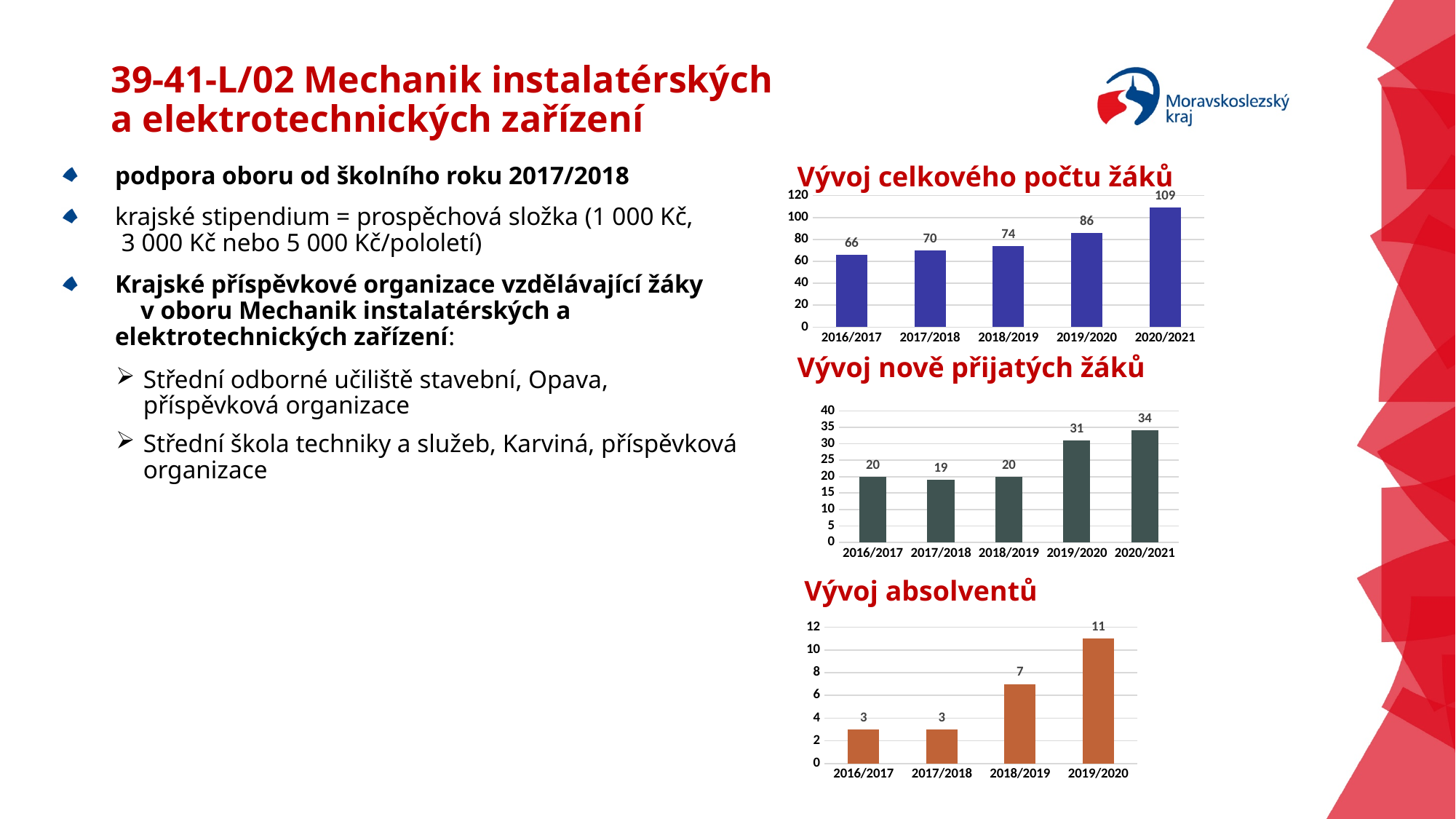
In the 'Vývoj celkového počtu žáků' chart, do the values rise or fall from 2016/2017 to 2020/2021? rise In the 'Vývoj celkového počtu žáků' chart, which school year has the lowest value? 2016/2017 In the 'Vývoj nově přijatých žáků' chart, which school year has the highest value? 2020/2021 In the 'Vývoj absolventů' chart, what is the difference between the values for 2019/2020 and 2016/2017? 8 What type of chart is the 'Vývoj absolventů' chart? bar chart In the 'Vývoj absolventů' chart, what is the value for 2018/2019? 7 In the 'Vývoj nově přijatých žáků' chart, what is the value for 2019/2020? 31 How many school years are shown in the 'Vývoj absolventů' chart? 4 In the 'Vývoj celkového počtu žáků' chart, what is the value for 2020/2021? 109 How many school years are shown in the 'Vývoj nově přijatých žáků' chart? 5 In the 'Vývoj nově přijatých žáků' chart, which is larger, the value for 2016/2017 or 2017/2018? 2016/2017 In the 'Vývoj celkového počtu žáků' chart, what is the difference between the values for 2019/2020 and 2018/2019? 12